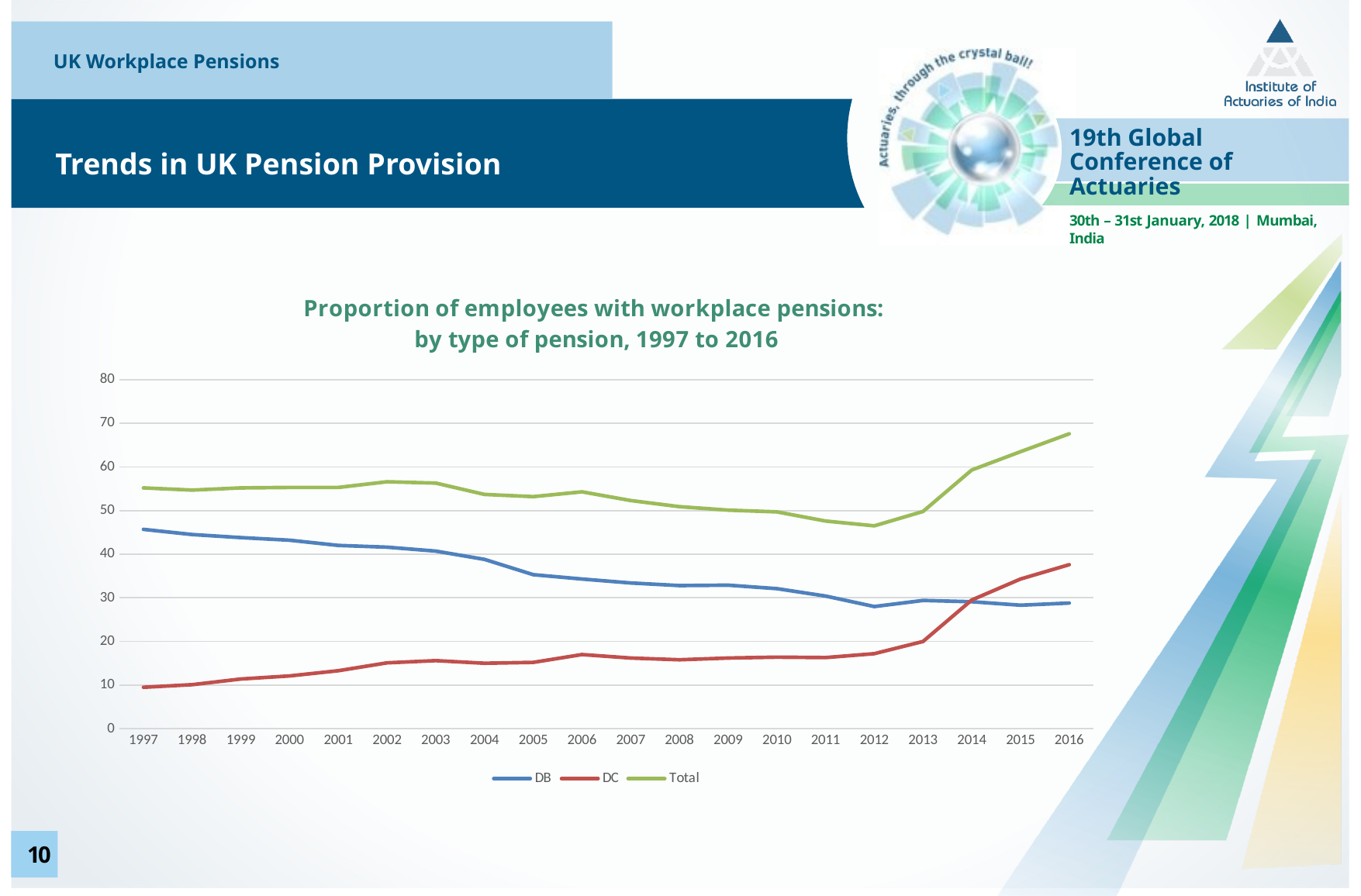
Does the DC line rise or fall overall from 1997 to 2016? rise Is the value for DB in 1997 greater or less than 40? greater What kind of chart is shown on the slide? line chart Does the DB line rise or fall overall from 1997 to 2016? fall How many series does the legend list? 3 Is the value for Total in 2016 greater or less than 60? greater How many years are plotted along the x axis? 20 Is the value for Total in 2012 greater or less than 50? less In 2016, which is higher, DB or DC? DC In which year is the Total line at its highest? 2016 In 2010, which is higher, DB or DC? DB